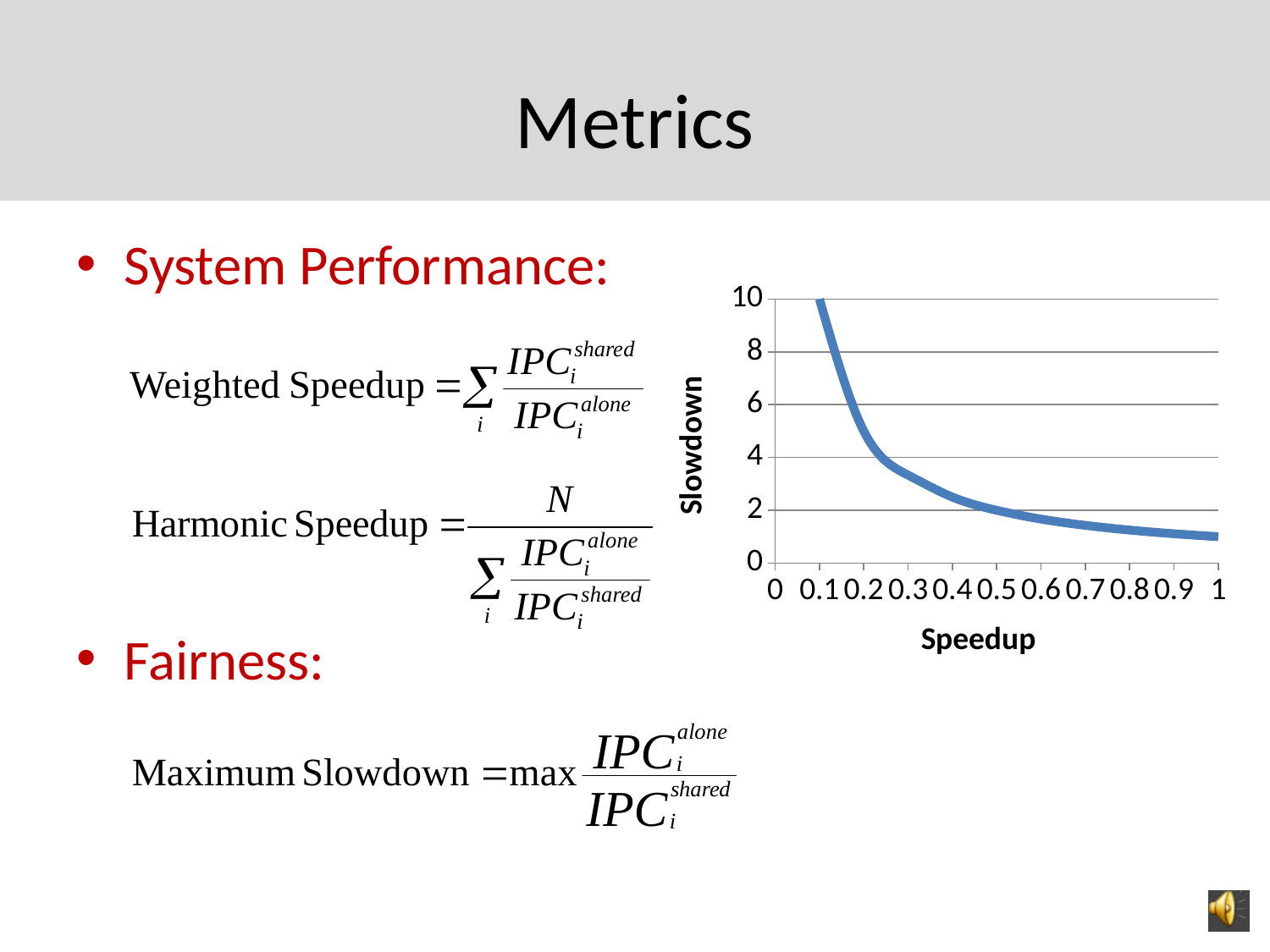
At which Speedup value on the x axis is the plotted Slowdown lowest? 1 Which has the larger Slowdown: a Speedup of 0.2 or a Speedup of 0.8? 0.2 What is the title of the y axis of the chart? Slowdown What kind of chart is shown on the slide? line chart Is the Slowdown value at a Speedup of 0.1 greater or less than 8? greater Is the Slowdown value at a Speedup of 0.8 greater or less than 2? less As Speedup increases along the x axis, does Slowdown rise or fall? fall What is the title of the x axis of the chart? Speedup Is the Slowdown value at a Speedup of 0.2 greater or less than 4? greater At which Speedup value on the x axis is the plotted Slowdown highest? 0.1